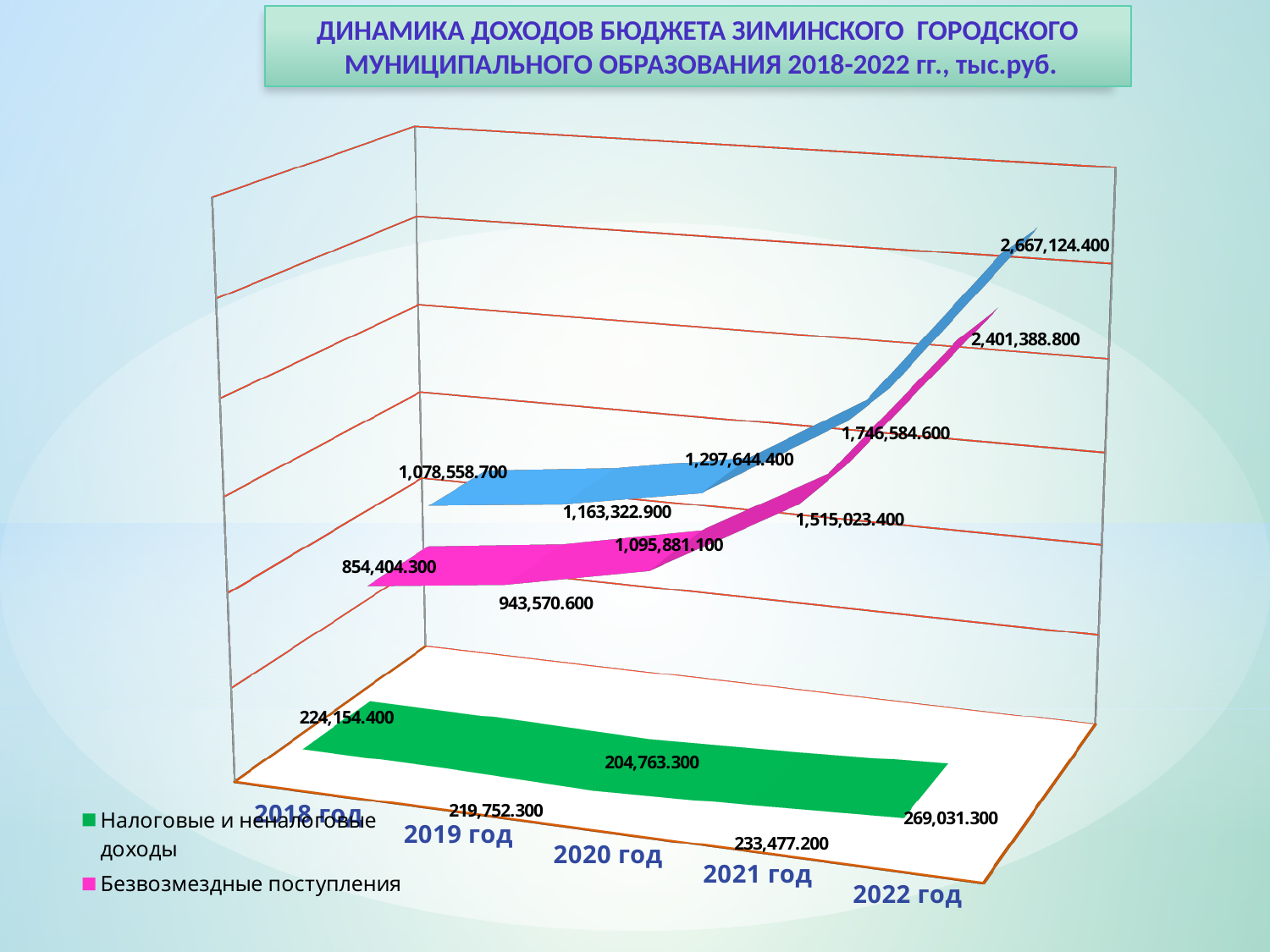
What is the difference between Безвозмездные поступления in 2022 год and 2021 год? 886,365.400 How many series does the legend list? 2 How many years are shown on the x axis? 5 What is the value of Безвозмездные поступления for 2020 год? 1,095,881.100 In which year is Налоговые и неналоговые доходы lowest? 2020 год What is the difference between Налоговые и неналоговые доходы in 2022 год and 2018 год? 44,876.900 What is the value of Безвозмездные поступления for 2022 год? 2,401,388.800 What is the value of Налоговые и неналоговые доходы for 2018 год? 224,154.400 In which year is Безвозмездные поступления highest? 2022 год Does Безвозмездные поступления rise or fall from 2018 год to 2022 год? rise Which is larger: Налоговые и неналоговые доходы in 2019 год or in 2022 год? 2022 год What is the value of Налоговые и неналоговые доходы for 2021 год? 233,477.200